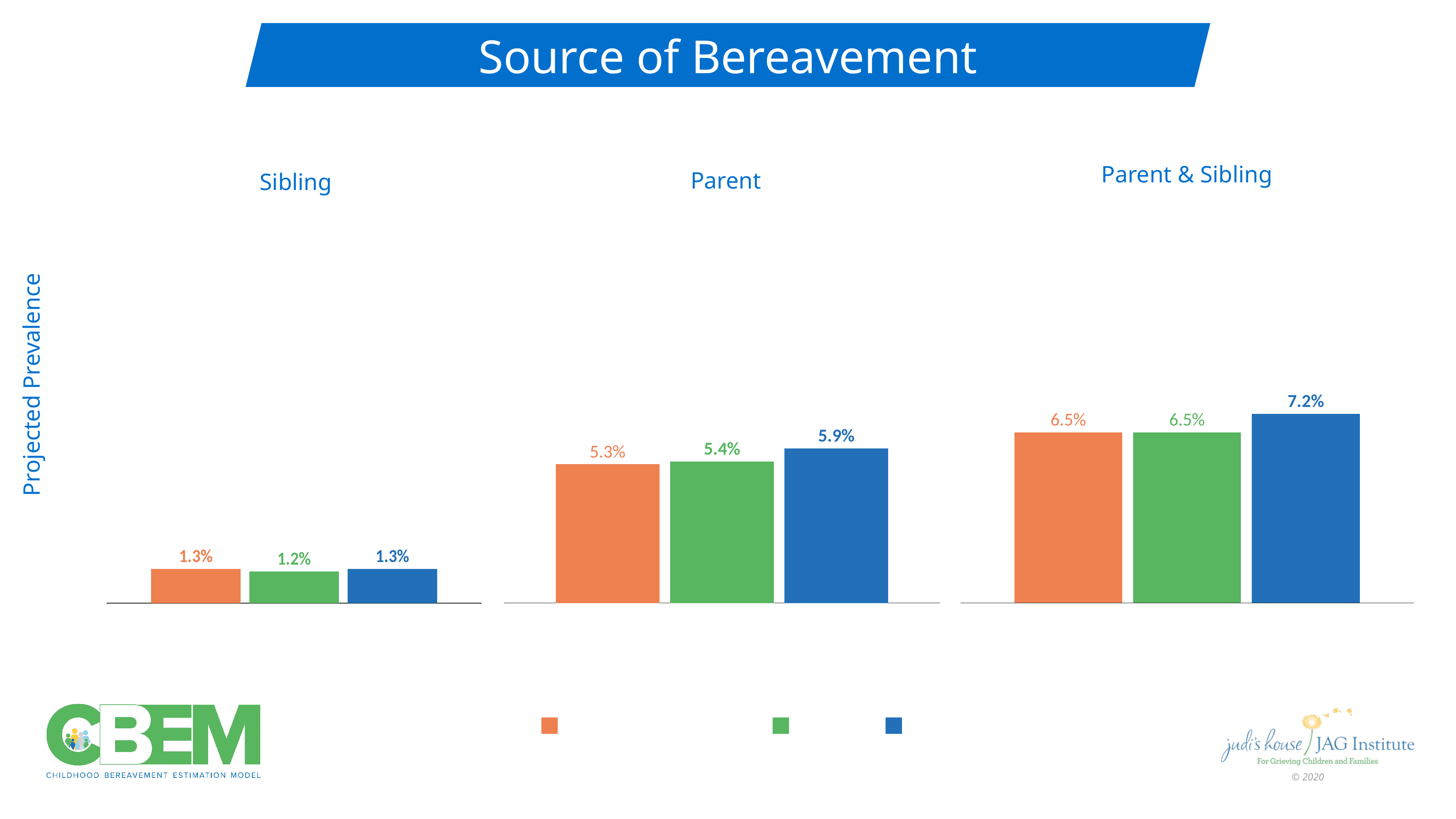
In the Parent chart, what is the difference between the blue bar and the green bar? 0.5% In the Parent chart, which coloured bar has the highest value? blue In the Parent chart, what is the value of the blue bar? 5.9% What type of chart is used on this slide? bar chart How many bars are shown in the Parent chart? 3 In the Sibling chart, which coloured bar has the lowest value? green In the Sibling chart, what is the value of the orange bar? 1.3% In the Parent & Sibling chart, what is the difference between the blue bar and the orange bar? 0.7% In the Parent & Sibling chart, what is the value of the green bar? 6.5% In the Parent & Sibling chart, what is the value of the blue bar? 7.2% In the Sibling chart, what is the value of the green bar? 1.2% In the Parent chart, what is the value of the orange bar? 5.3%